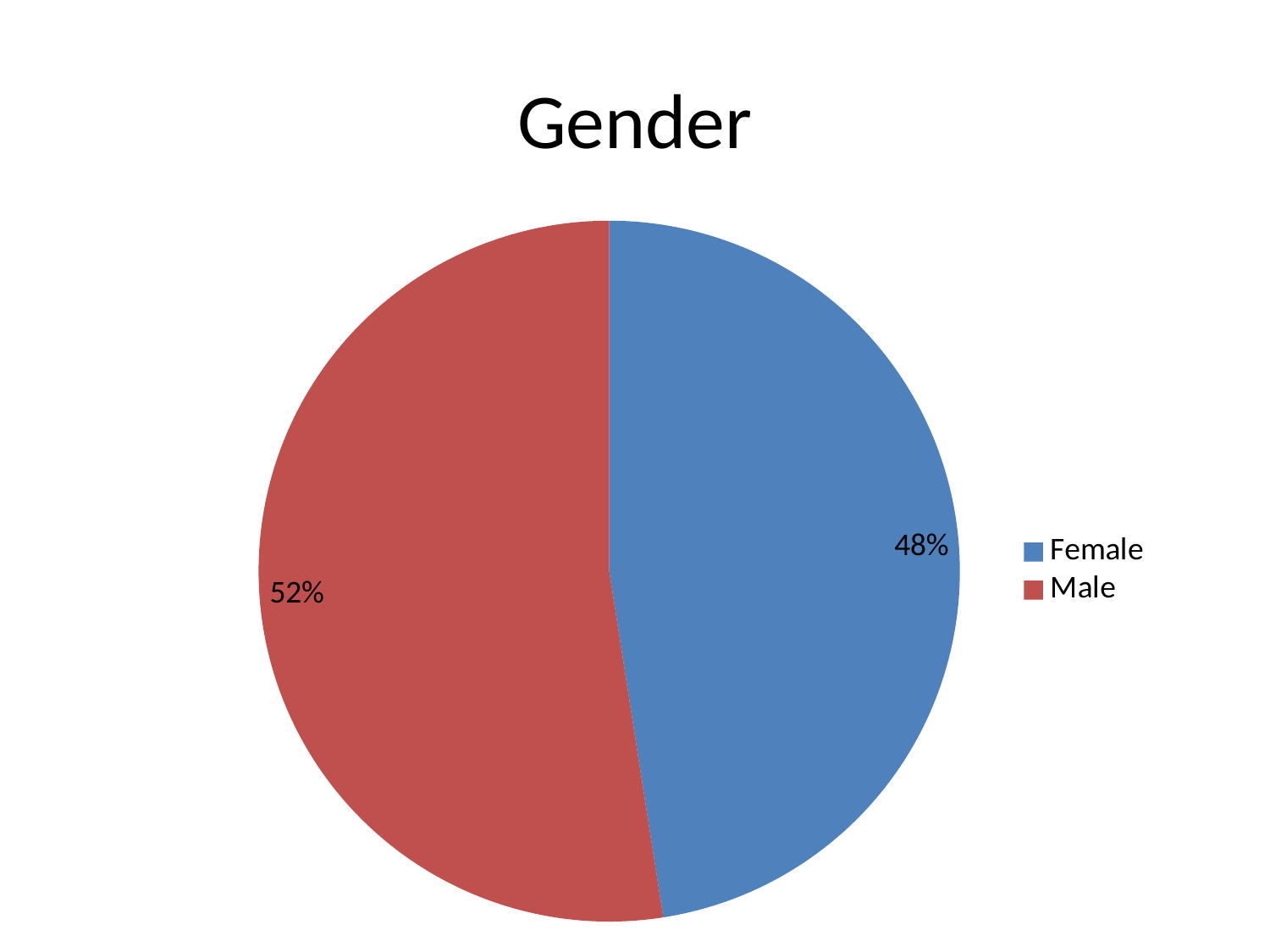
Which category has the largest share of the pie? Male How many slices does the pie chart have? 2 How many entries does the legend list? 2 What kind of chart is shown on the slide? pie chart Which is larger, the Female share or the Male share? Male What is the difference in percentage points between the Male and Female shares? 4 What share of the pie is Male? 52% What share of the pie is Female? 48% Is the Male share greater or less than 50%? greater What is the title of the chart? Gender Which colour represents Female in the chart? blue Which category has the smallest share of the pie? Female